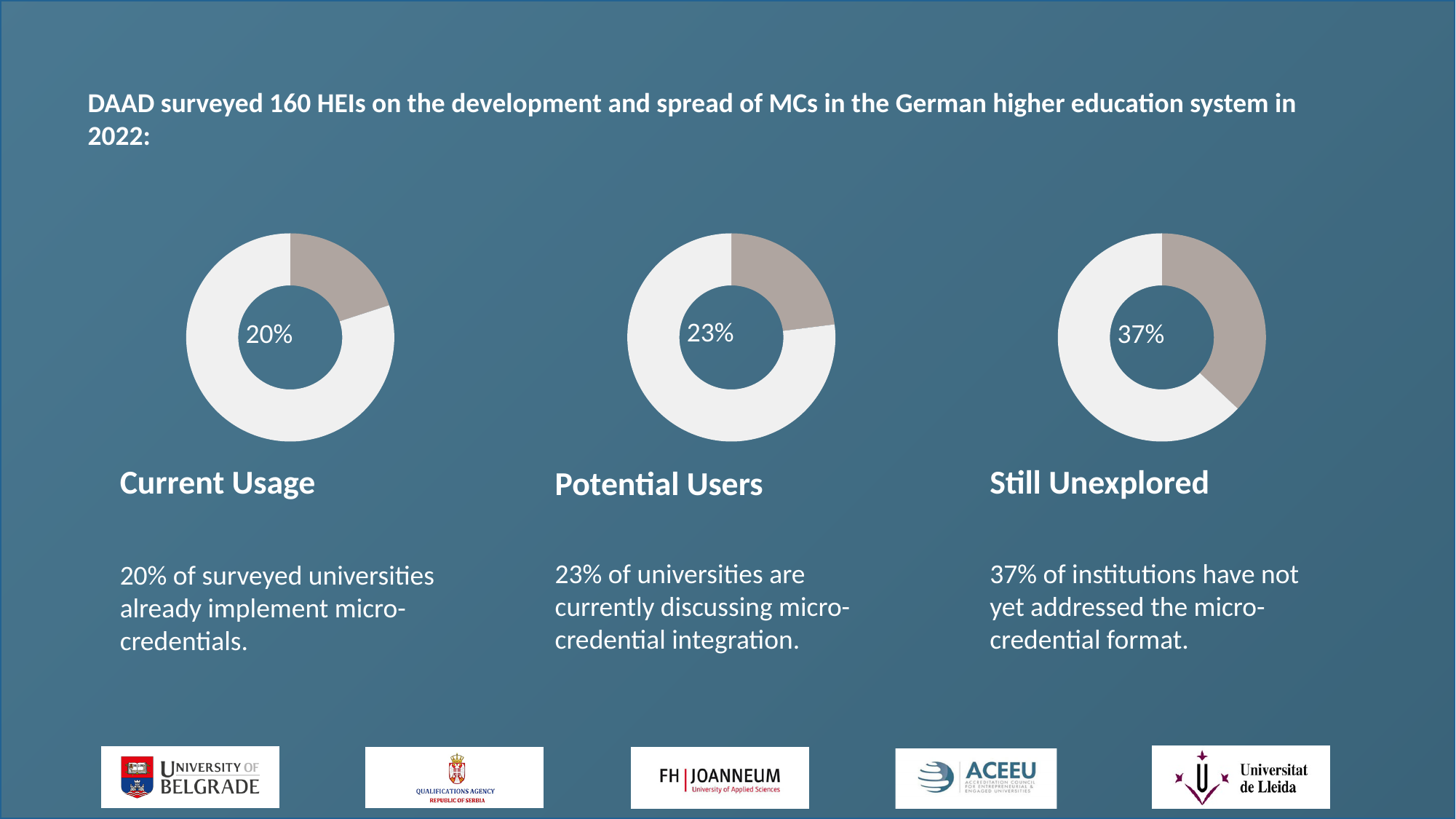
What is the difference between the percentage in the 'Potential Users' chart and the percentage in the 'Current Usage' chart? 3% What kind of chart is used for 'Current Usage', 'Potential Users' and 'Still Unexplored'? Donut chart What value is shown in the centre of the 'Potential Users' donut chart? 23% What value is shown in the centre of the 'Still Unexplored' donut chart? 37% Which of the three donut charts shows the lowest percentage? Current Usage What value is shown in the centre of the 'Current Usage' donut chart? 20% Which is larger: the percentage in the 'Potential Users' chart or the percentage in the 'Still Unexplored' chart? Still Unexplored Which of the three donut charts shows the highest percentage? Still Unexplored How many donut charts are shown on the slide? 3 What is the difference between the percentage in the 'Still Unexplored' chart and the percentage in the 'Current Usage' chart? 17% What is the title of the leftmost donut chart on the slide? Current Usage In the 'Still Unexplored' donut chart, what share of the ring is shaded in the darker grey colour? 37%